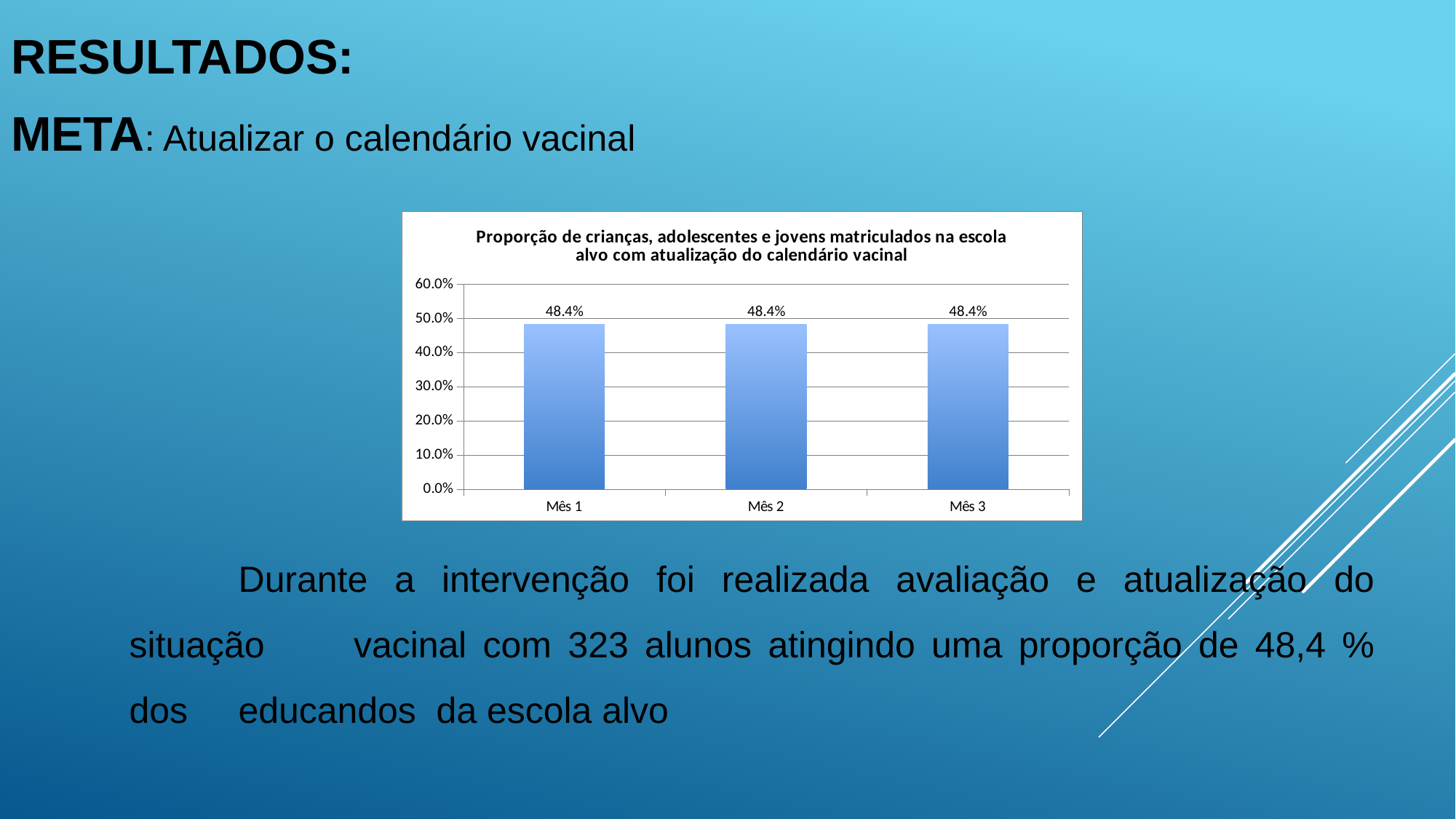
What is the value for Mês 2? 48.4% What is the value for Mês 3? 48.4% What is the title of the chart? Proporção de crianças, adolescentes e jovens matriculados na escola alvo com atualização do calendário vacinal Do the values rise, fall, or stay the same from Mês 1 to Mês 3? Stay the same What kind of chart is shown on the slide? Bar chart How many categories are shown on the x axis? 3 What is the value for Mês 1? 48.4% What is the highest value shown on the y axis? 60.0% What is the difference between the values for Mês 1 and Mês 3? 0.0% Is the value for Mês 3 greater or less than 50.0%? less Is the value for Mês 2 greater or less than 40.0%? greater